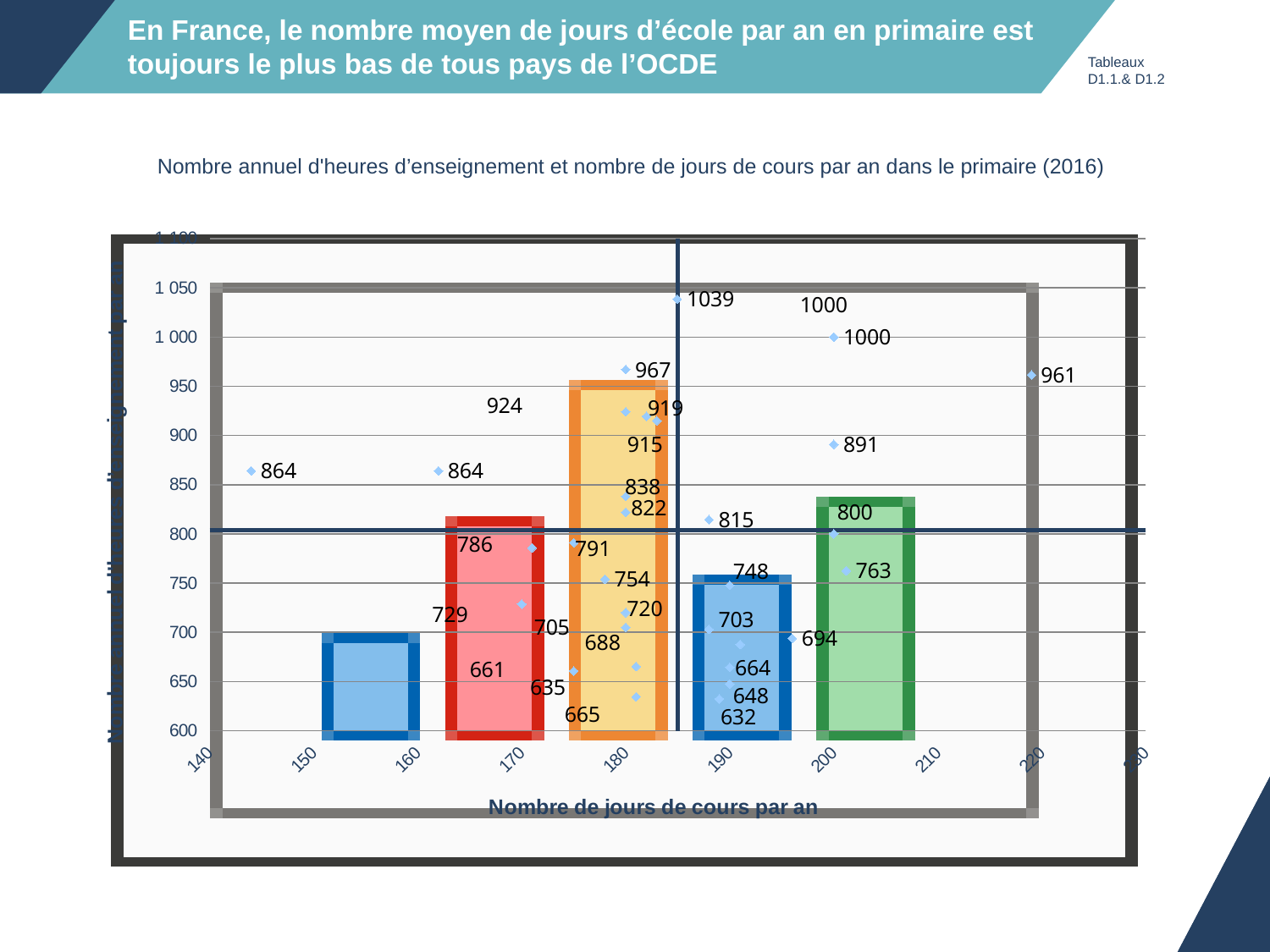
What is the difference between the highest labeled value (1039) and the lowest labeled value (632) in the chart? 407 Is the number of days of school for the point labeled 961 greater or less than 210? greater What is the title of the horizontal axis of the chart? Nombre de jours de cours par an How many tick labels are shown on the horizontal axis of the chart? 10 What is the difference between the labeled values 1000 and 961? 39 Is the number of days of school for the leftmost point labeled 864 greater or less than 150? less Is the number of days of school for the point labeled 1039 greater or less than 180? greater What is the lowest value labeled on a data point in the chart? 632 What kind of chart is shown on the slide? scatter chart What is the title of the chart? Nombre annuel d'heures d'enseignement et nombre de jours de cours par an dans le primaire (2016) What is the highest value labeled on a data point in the chart? 1039 Which labeled value is larger, 967 or 919? 967